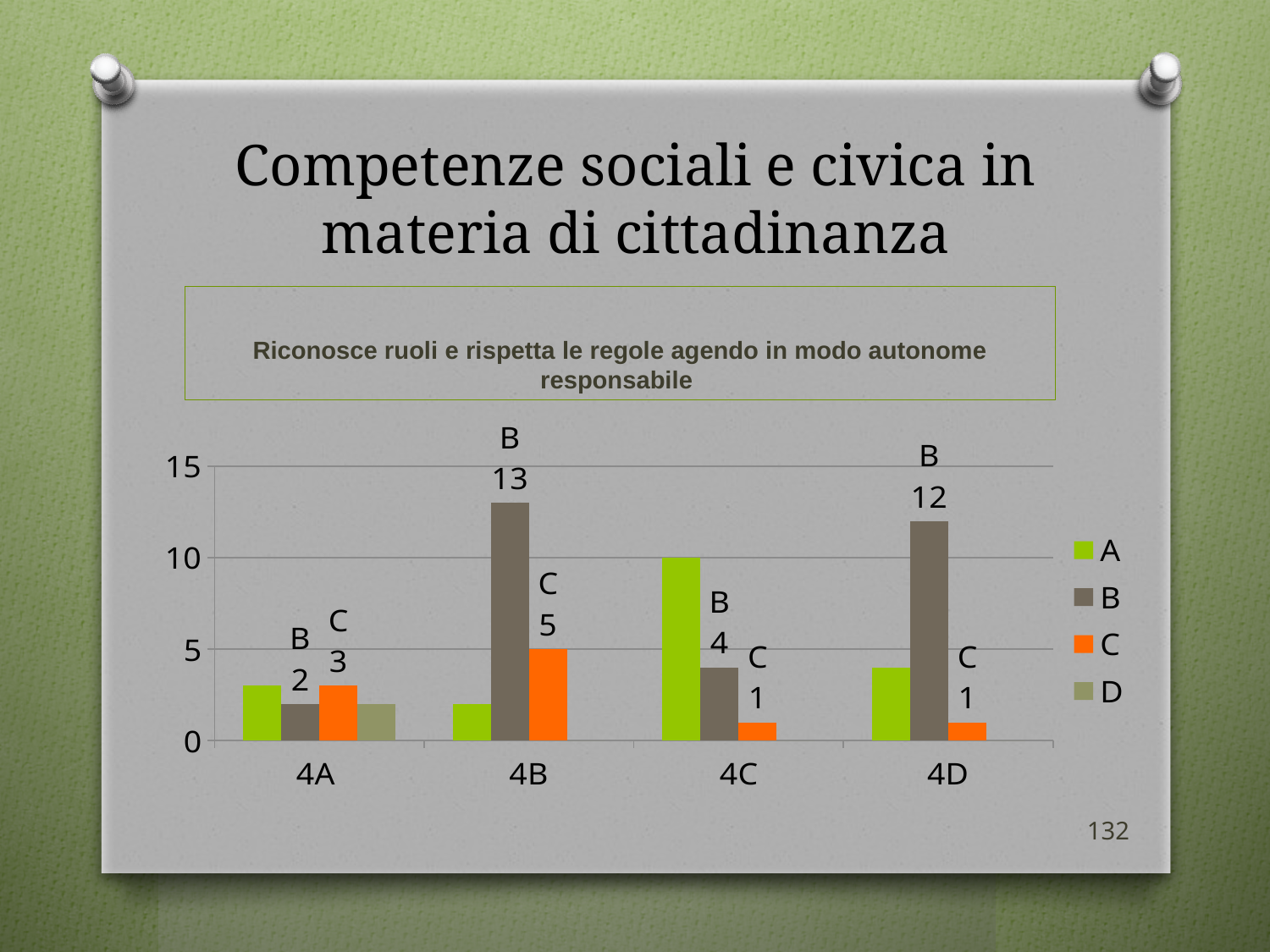
In class 4C, what is the difference between the B value and the C value? 3 What is the value of series C for class 4A? 3 Which class has the highest value for series B? 4B What is the difference between the B value for 4B and the B value for 4D? 1 Is the value of series A for class 4C greater or less than 5? greater Which is larger: the C value for 4B or the C value for 4A? C value for 4B How many classes are shown on the x axis? 4 What is the value of series B for class 4D? 12 Which class has the lowest value for series B? 4A How many series does the legend list? 4 What is the value of series C for class 4B? 5 What is the value of series B for class 4B? 13